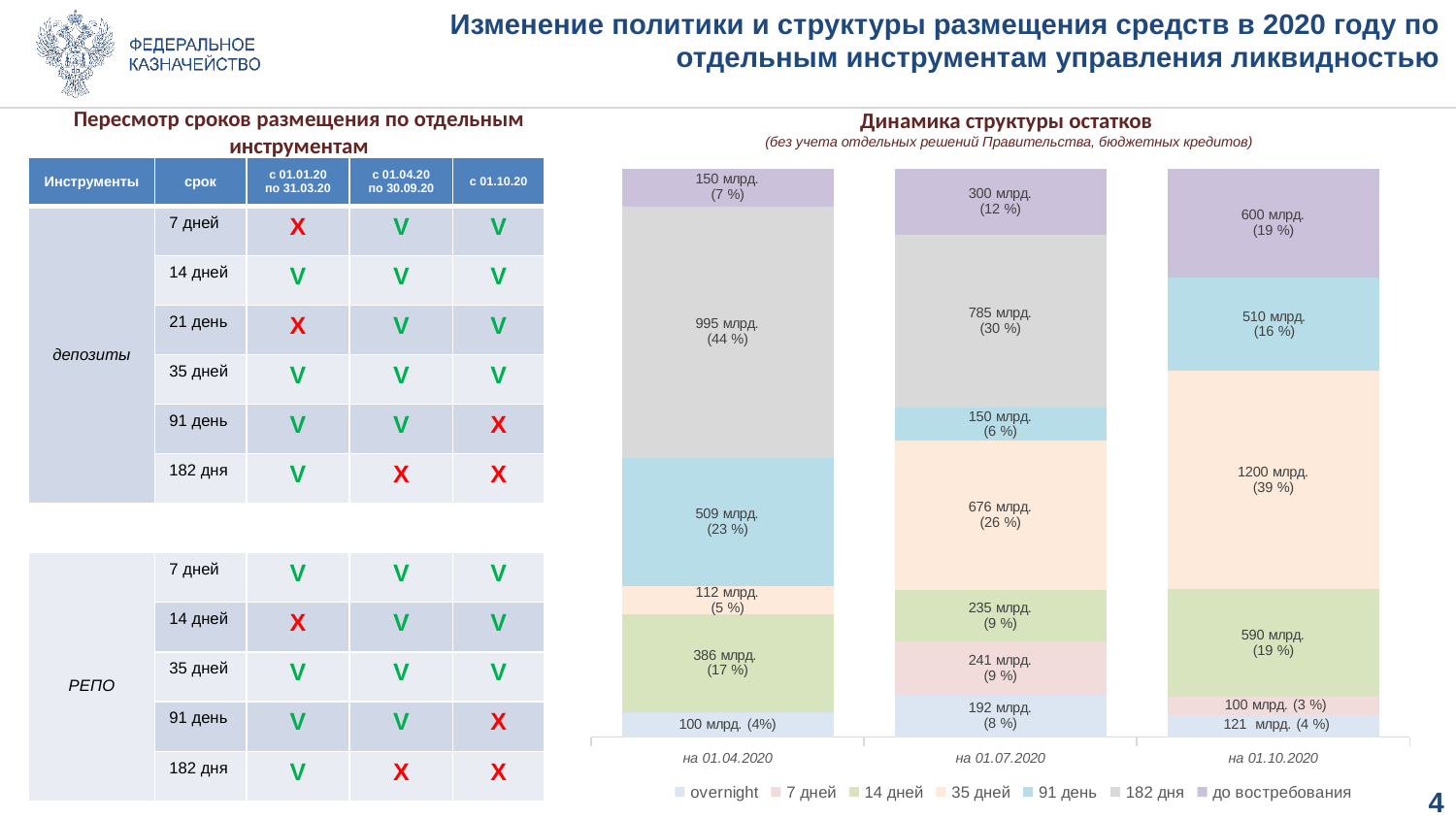
How many bars (dates) are shown in the «Динамика структуры остатков» chart? 3 In the «Динамика структуры остатков» chart, which segment is the smallest in the bar for «на 01.10.2020»? 7 дней (100 млрд.) In the «Динамика структуры остатков» chart, which segment is the largest in the bar for «на 01.07.2020»? 182 дня (785 млрд.) In the «Динамика структуры остатков» chart, what is the total of the bar for «на 01.10.2020»? 3121 млрд. In the «Динамика структуры остатков» chart, what is the difference between the «до востребования» values for «на 01.10.2020» and «на 01.04.2020»? 450 млрд. In the «Динамика структуры остатков» chart, what is the value of the «overnight» segment for «на 01.07.2020»? 192 млрд. (8 %) How many series does the legend of the «Динамика структуры остатков» chart list? 7 In the «Динамика структуры остатков» chart, what share does the «14 дней» segment have in the bar for «на 01.04.2020»? 17 % What kind of chart is shown under the title «Динамика структуры остатков»? Stacked bar chart In the «Динамика структуры остатков» chart, what is the value of the «182 дня» segment for «на 01.04.2020»? 995 млрд. (44 %) In the «Динамика структуры остатков» chart, what is the value of the «35 дней» segment for «на 01.10.2020»? 1200 млрд. (39 %) In the «Динамика структуры остатков» chart, which is larger: the «91 день» segment for «на 01.04.2020» or for «на 01.07.2020»? на 01.04.2020 (509 млрд.)